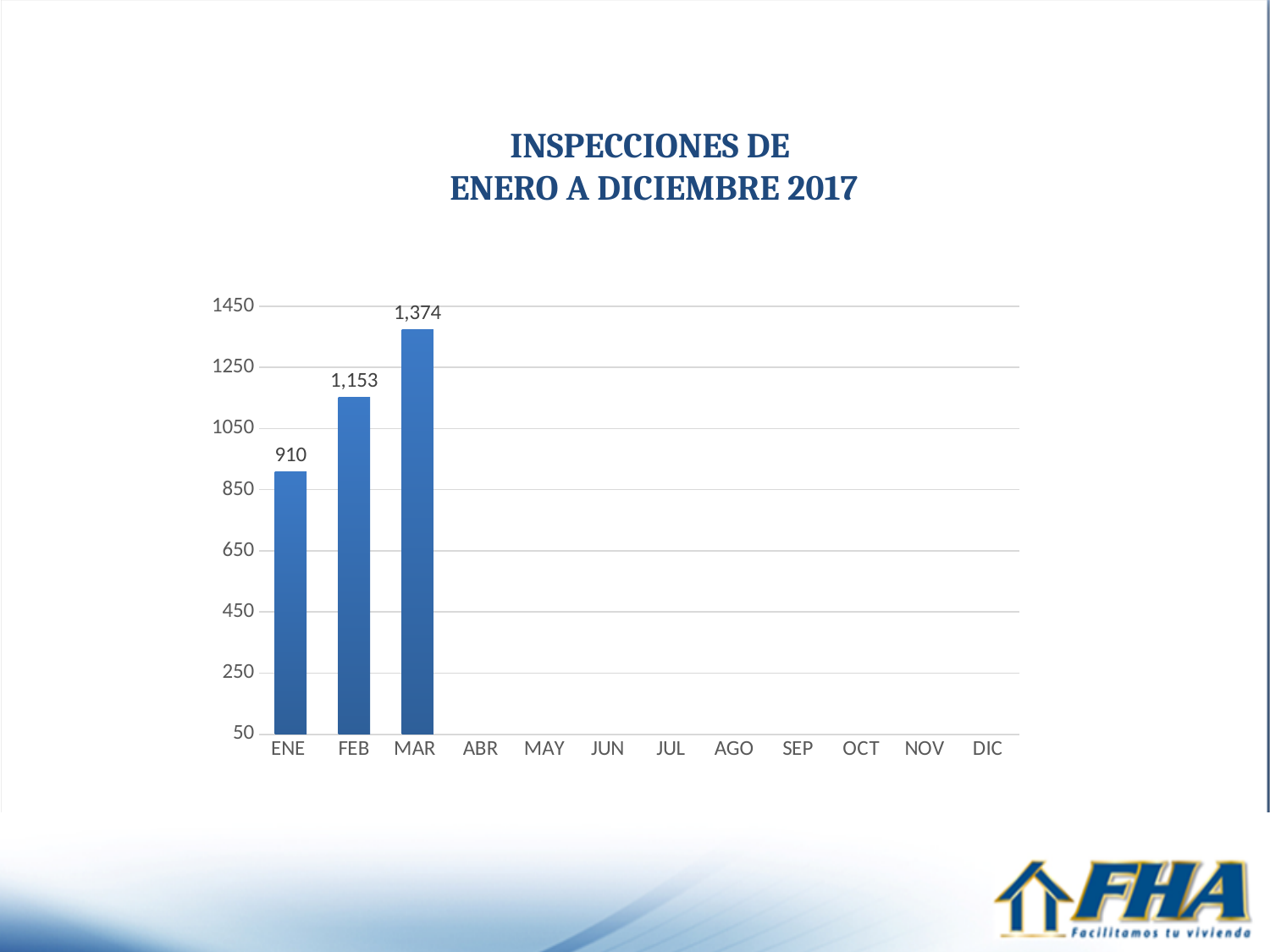
What is the difference between the values for MAR and FEB? 221 What is the value for FEB? 1,153 Do the values rise or fall from ENE to MAR? rise What is the difference between the values for FEB and ENE? 243 Is the value for MAR greater or less than 1250? greater Which month has the lowest value among the plotted bars? ENE Which month has the highest value among the plotted bars? MAR What kind of chart is shown on the slide? bar chart How many months are labelled on the x axis? 12 What is the value for ENE? 910 Which is larger, the value for ENE or the value for FEB? FEB What is the value for MAR? 1,374